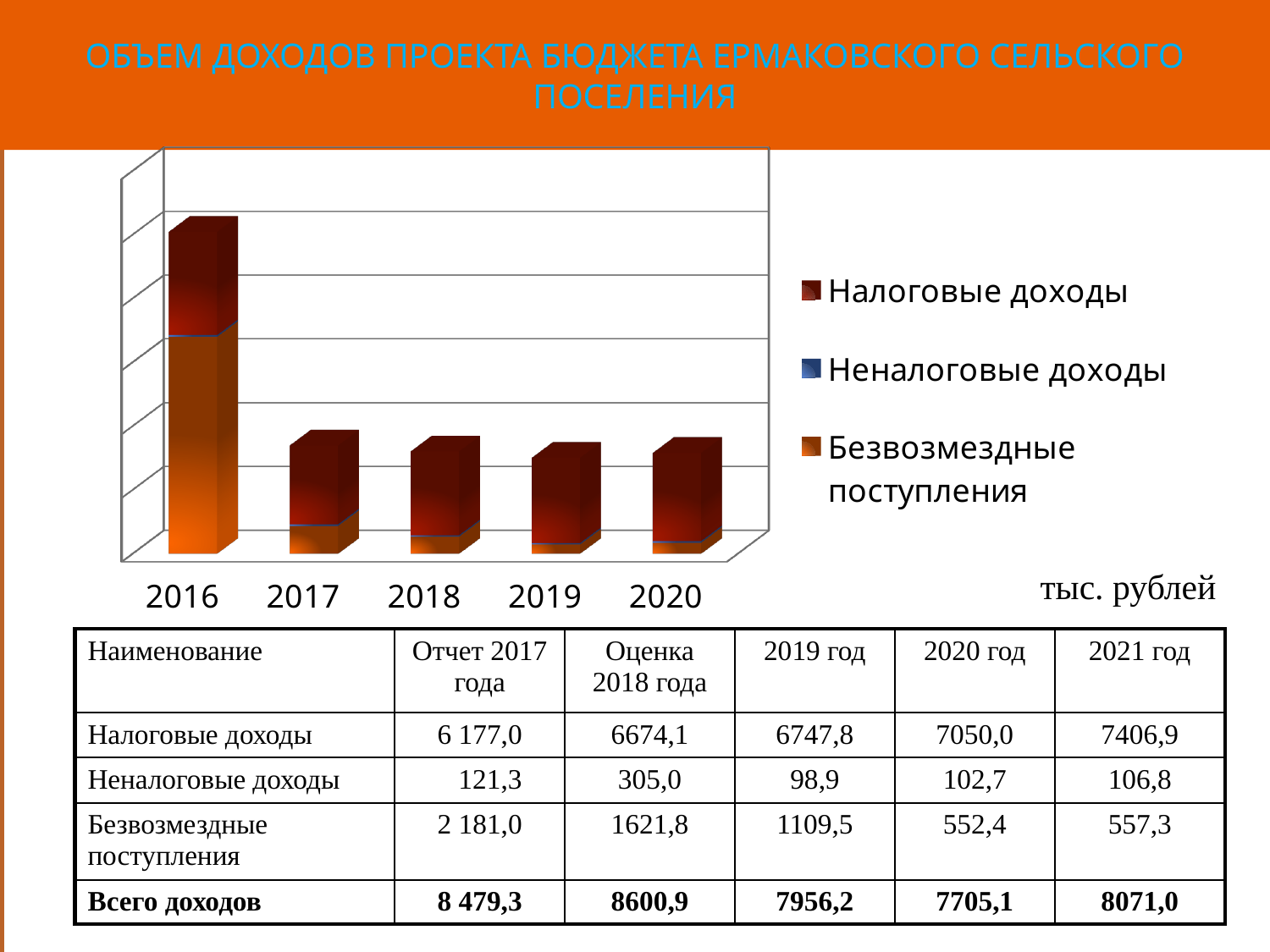
Which series is listed last in the chart legend? Безвозмездные поступления How many years are shown along the x axis of the chart? 5 Which bar is taller in the chart, 2016 or 2017? 2016 How many series does the chart legend list? 3 Which series is listed first in the chart legend? Налоговые доходы Which year has the tallest bar in the chart? 2016 Which bar is taller in the chart, 2017 or 2019? 2017 What is the first year shown on the x axis of the chart? 2016 What is the last year shown on the x axis of the chart? 2020 What kind of chart is shown on the slide? bar chart